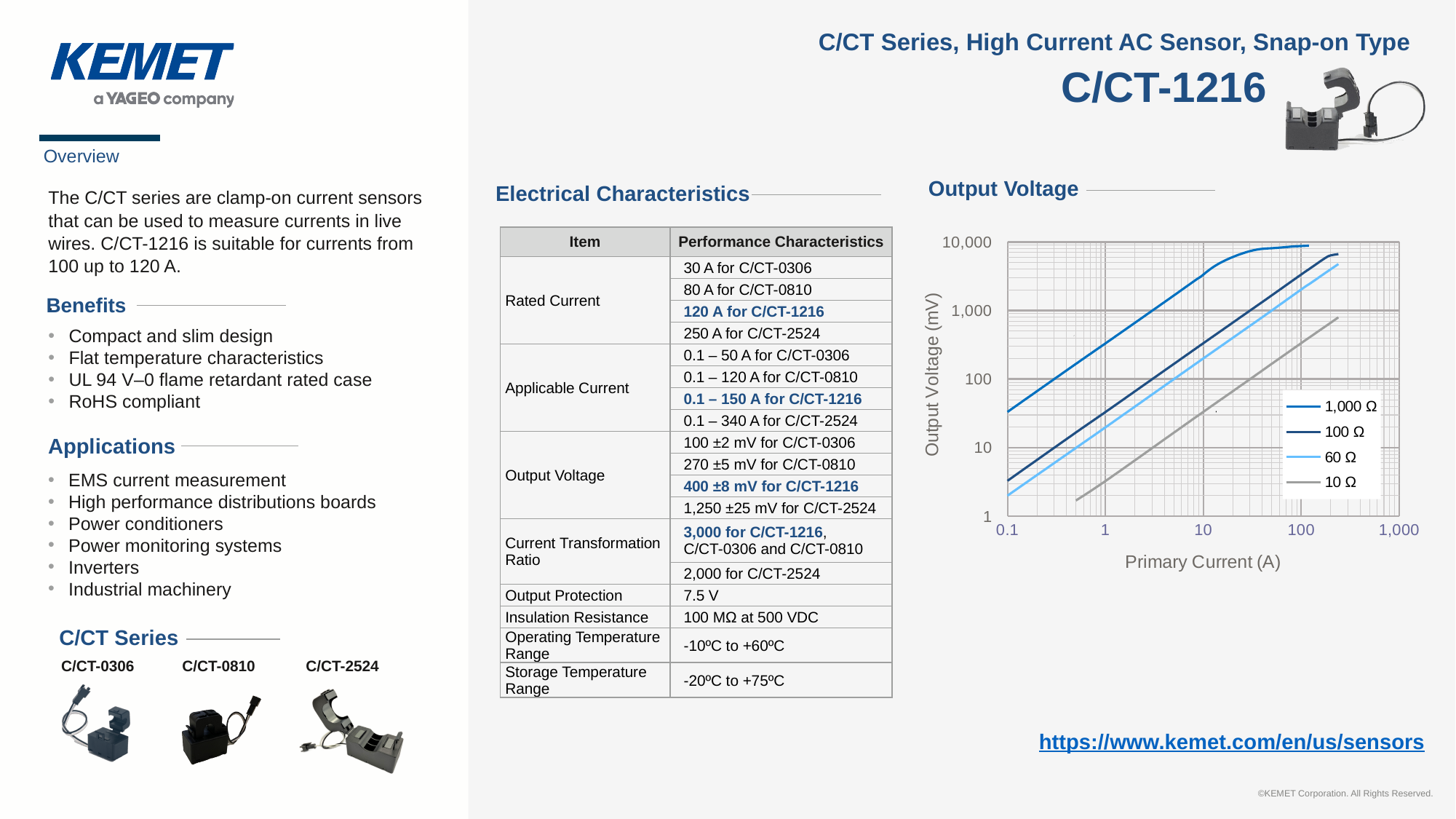
In the Output Voltage chart, is the output voltage for the 10 Ω series at 10 A greater or less than 100 mV? less What kind of chart is the Output Voltage chart? line chart In the Output Voltage chart, is the output voltage for the 1,000 Ω series at 10 A greater or less than 1,000 mV? greater In the Output Voltage chart, is the output voltage for the 100 Ω series at 100 A greater or less than 1,000 mV? greater In the Output Voltage chart, which load resistance series gives the highest output voltage at any given primary current? 1,000 Ω How many series does the legend of the Output Voltage chart list? 4 In the Output Voltage chart, which load resistance series gives the lowest output voltage at any given primary current? 10 Ω What is the label of the y axis of the Output Voltage chart? Output Voltage (mV) In the Output Voltage chart, at 1 A, which series has the larger output voltage: 100 Ω or 60 Ω? 100 Ω In the Output Voltage chart, does the output voltage rise or fall as primary current increases? rise What is the highest value shown on the y axis of the Output Voltage chart? 10,000 What is the label of the x axis of the Output Voltage chart? Primary Current (A)